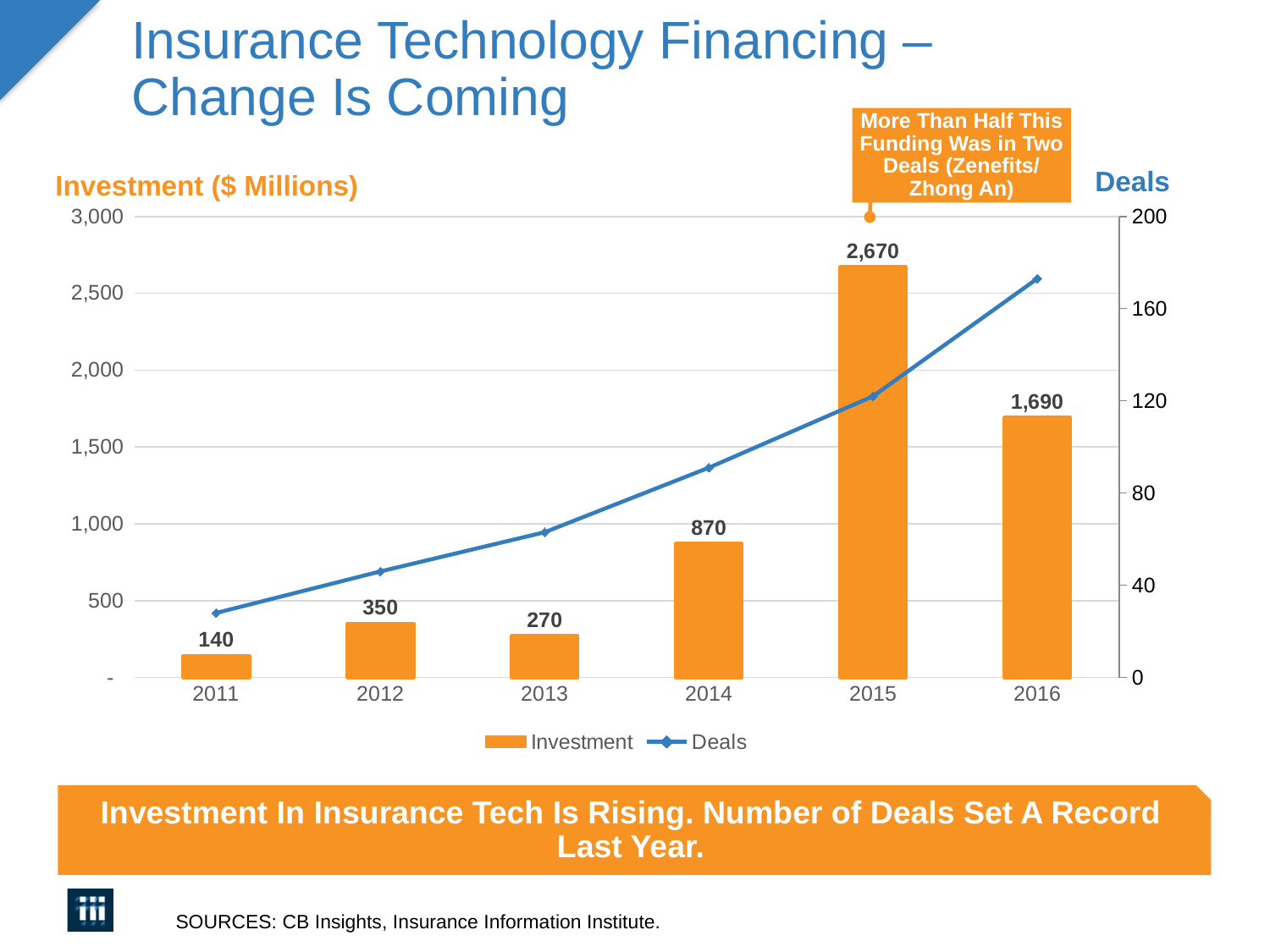
Does the number of deals rise or fall from 2011 to 2016? rise What is the difference in investment between 2015 and 2016? 980 How many series does the legend list? 2 Is the number of deals for 2011 greater or less than 40? less Which year has the larger investment, 2012 or 2013? 2012 What is the investment value for 2011? 140 How many years are shown on the x axis? 6 What is the investment value for 2014? 870 Is the number of deals for 2016 greater or less than 160? greater Which year has the highest investment? 2015 Which year has the lowest investment? 2011 What is the investment value for 2015? 2,670